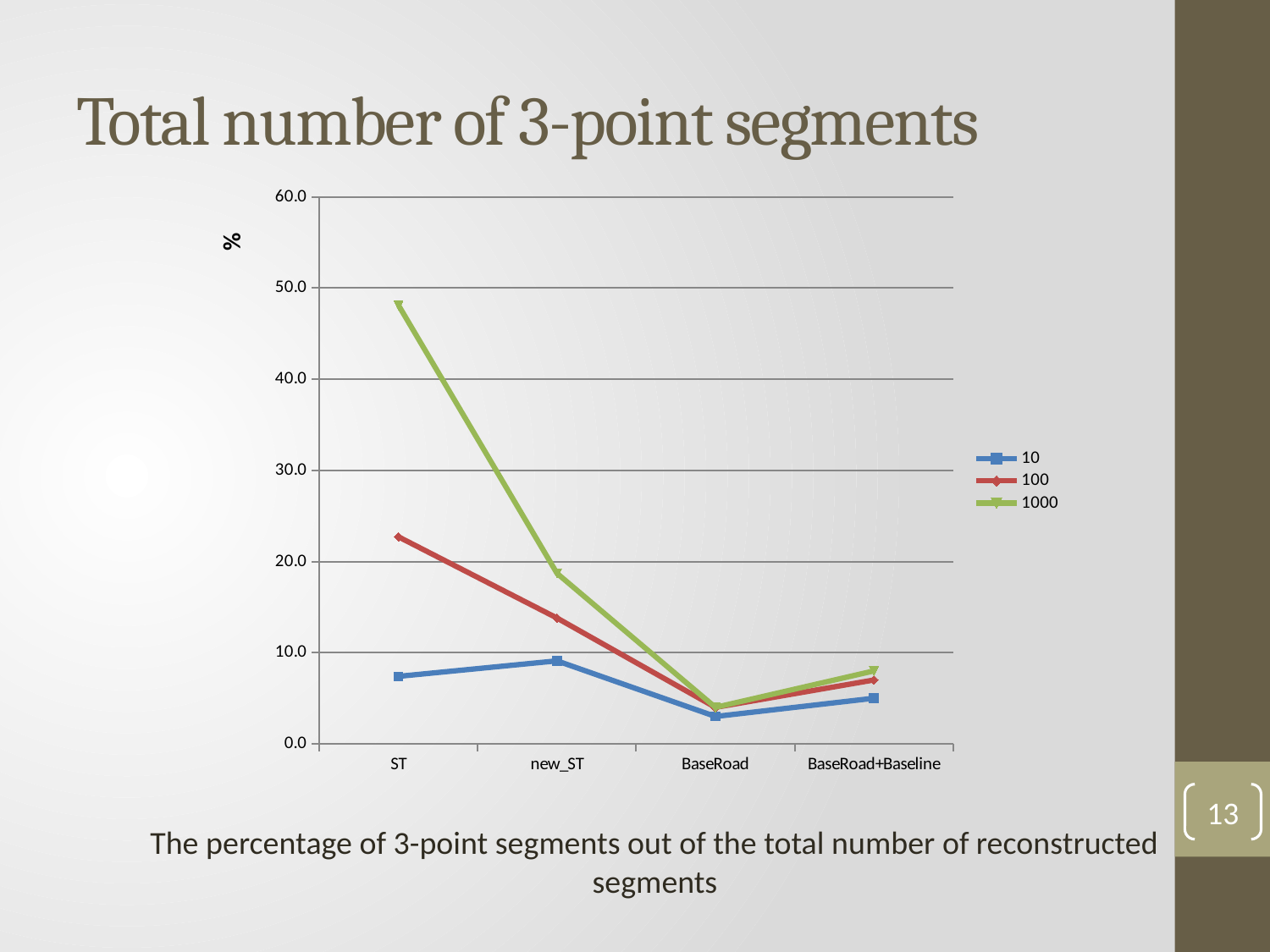
How many categories are shown on the x axis? 4 For the 10 series, which category has the lowest value? BaseRoad At ST, which series has the larger value, 1000 or 100? 1000 What is the label on the y axis? % For the 1000 series, which category has the highest value? ST Is the value for the 100 series at ST greater or less than 20.0? greater Is the value for the 1000 series at ST greater or less than 40.0? greater Is the value for the 10 series at new_ST greater or less than 10.0? less What kind of chart is shown on the slide? line chart For the 1000 series, which category has the lowest value? BaseRoad Does the 1000 series rise or fall from ST to BaseRoad? fall How many series does the legend list? 3